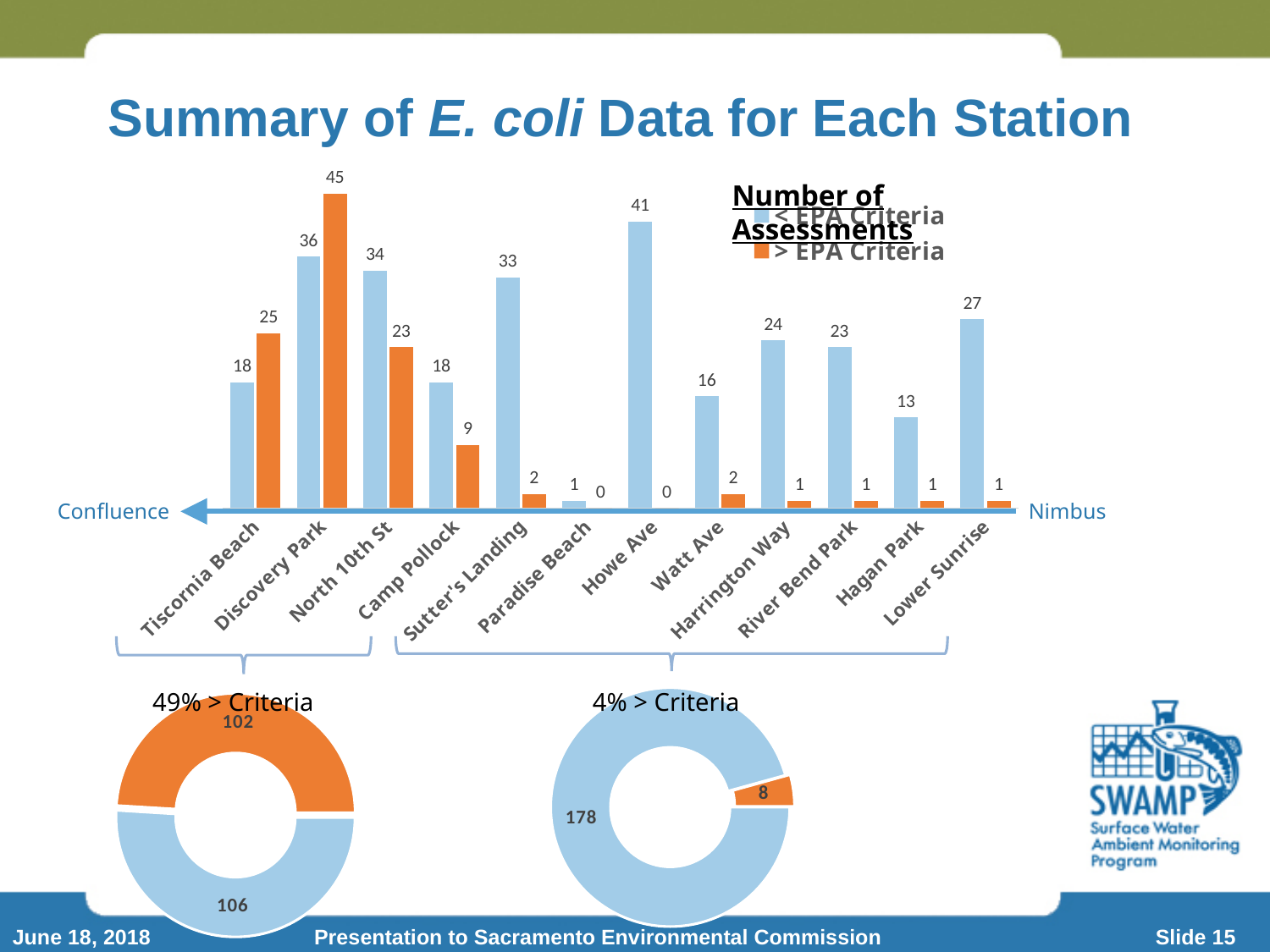
How many stations are shown on the x axis of the bar chart? 12 In the bar chart, which is larger at Tiscornia Beach: the < EPA Criteria count or the > EPA Criteria count? > EPA Criteria In the bar chart, how many assessments at Howe Ave were < EPA Criteria? 41 In the bar chart, what colour represents the > EPA Criteria series? orange In the right donut chart (4% > Criteria), what is the total of the two segments? 186 What type of chart is the chart at the top of the slide showing assessments by station? bar chart In the bar chart, which station has the lowest number of assessments < EPA Criteria? Paradise Beach In the bar chart, which station has the highest number of assessments > EPA Criteria? Discovery Park In the left donut chart (49% > Criteria), what is the value of the orange segment? 102 In the bar chart, how many assessments at Discovery Park were > EPA Criteria? 45 In the bar chart, what is the difference between the < EPA Criteria and > EPA Criteria counts at North 10th St? 11 How many series does the legend of the bar chart list? 2